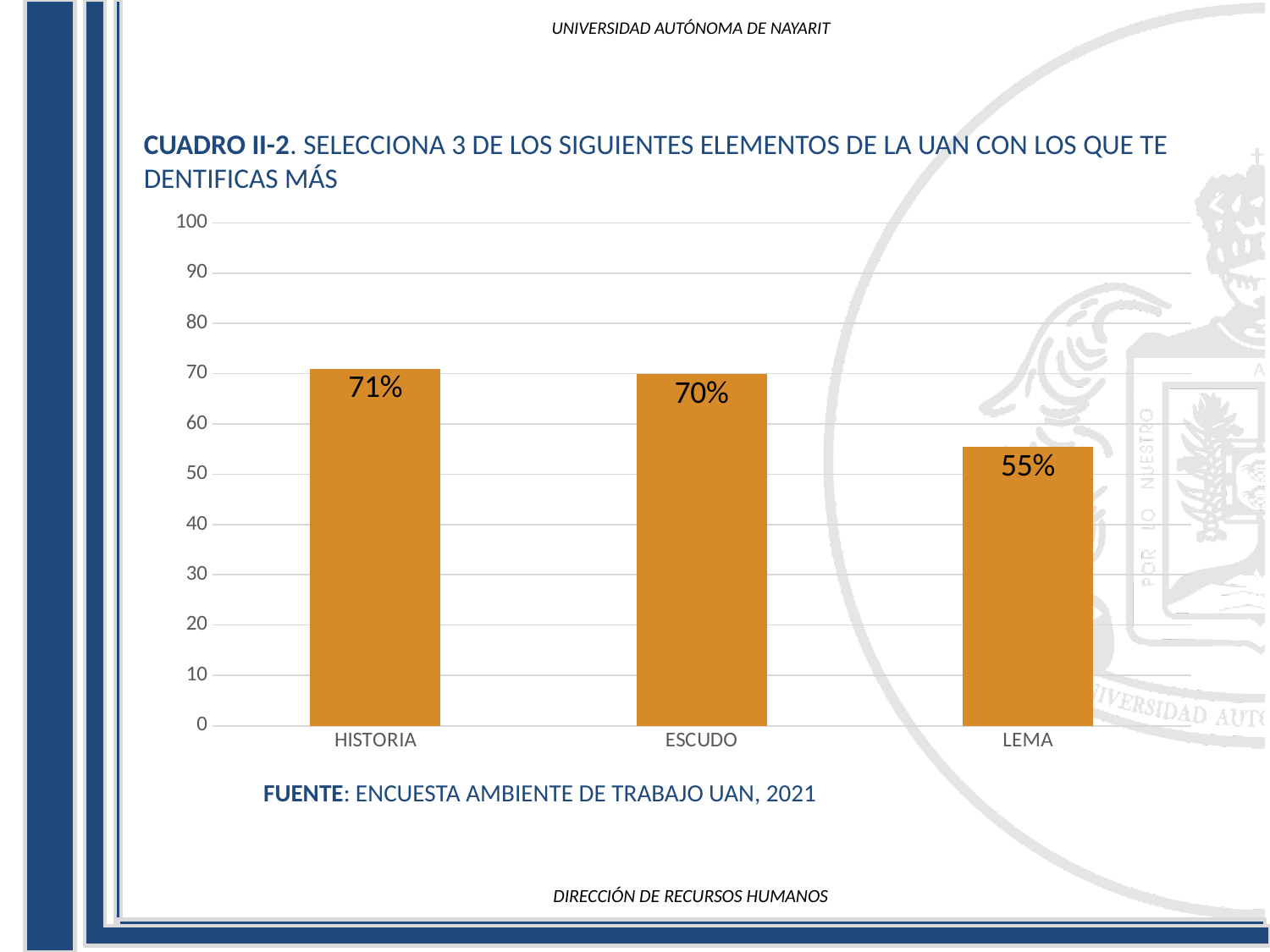
What is the difference between the values for ESCUDO and LEMA? 15% How many categories are shown on the chart? 3 What is the value for ESCUDO? 70% Which is larger, the value for ESCUDO or the value for LEMA? ESCUDO What kind of chart is shown on the slide? bar chart What source is cited below the chart? ENCUESTA AMBIENTE DE TRABAJO UAN, 2021 What is the difference between the values for HISTORIA and LEMA? 16% What is the value for LEMA? 55% Is the value for HISTORIA greater or less than 70? greater What is the value for HISTORIA? 71% Is the value for LEMA greater or less than 60? less Which category has the lowest value? LEMA